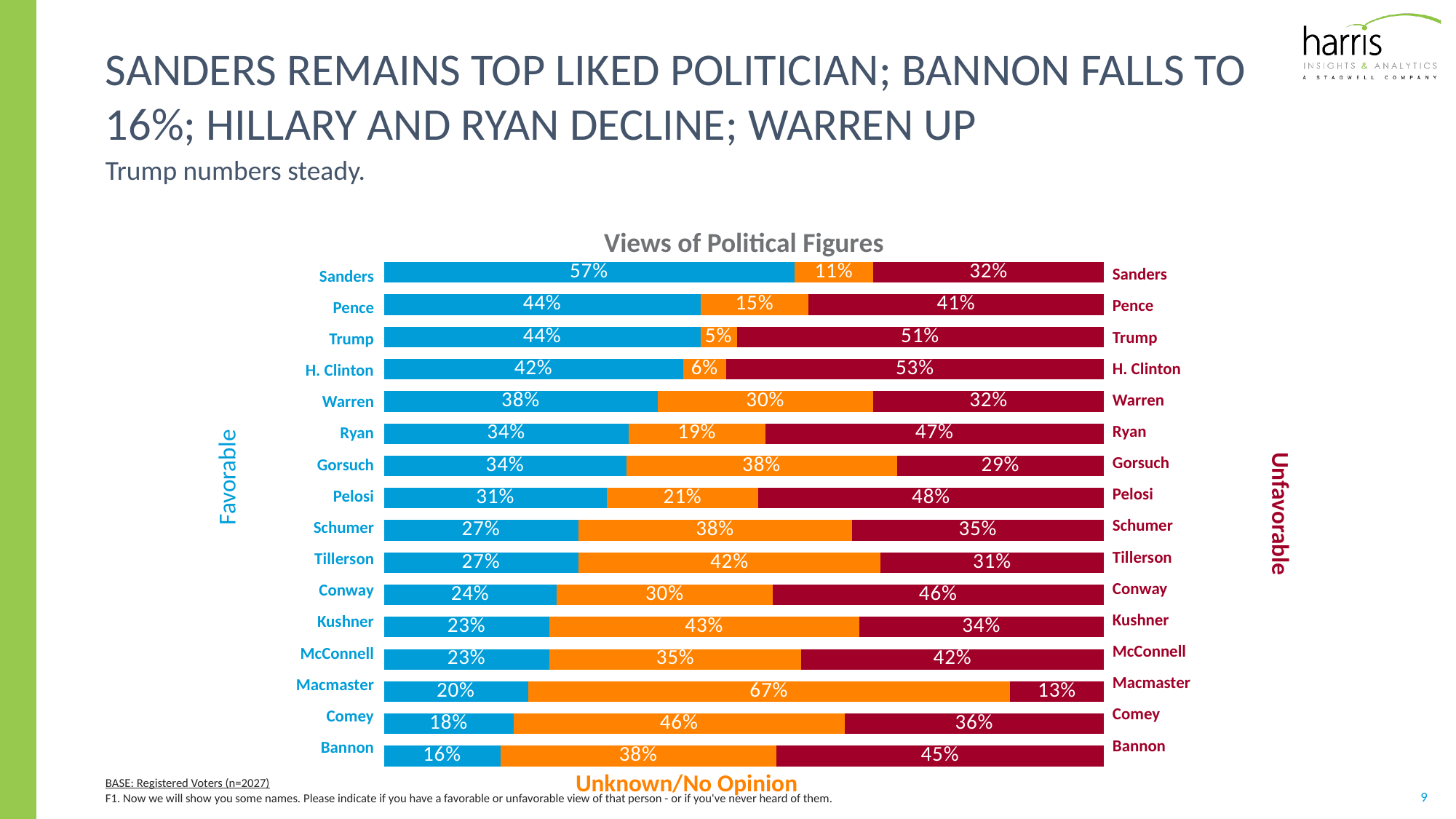
What is the Unfavorable value for H. Clinton? 53% Which political figure has the highest Favorable value? Sanders Which political figure has the lowest Unfavorable value? Macmaster What is the Favorable value for Sanders? 57% Which political figure has the lowest Favorable value? Bannon What is the title of the chart? Views of Political Figures What is the difference between Trump's Unfavorable and Favorable values? 7 percentage points Which is larger, the Unknown/No Opinion value for Gorsuch or for Warren? Gorsuch How many political figures are shown in the chart? 16 What is the Unknown/No Opinion value for Macmaster? 67% What kind of chart is shown on the slide? Stacked bar chart How many series (segments per bar) does the chart show? 3